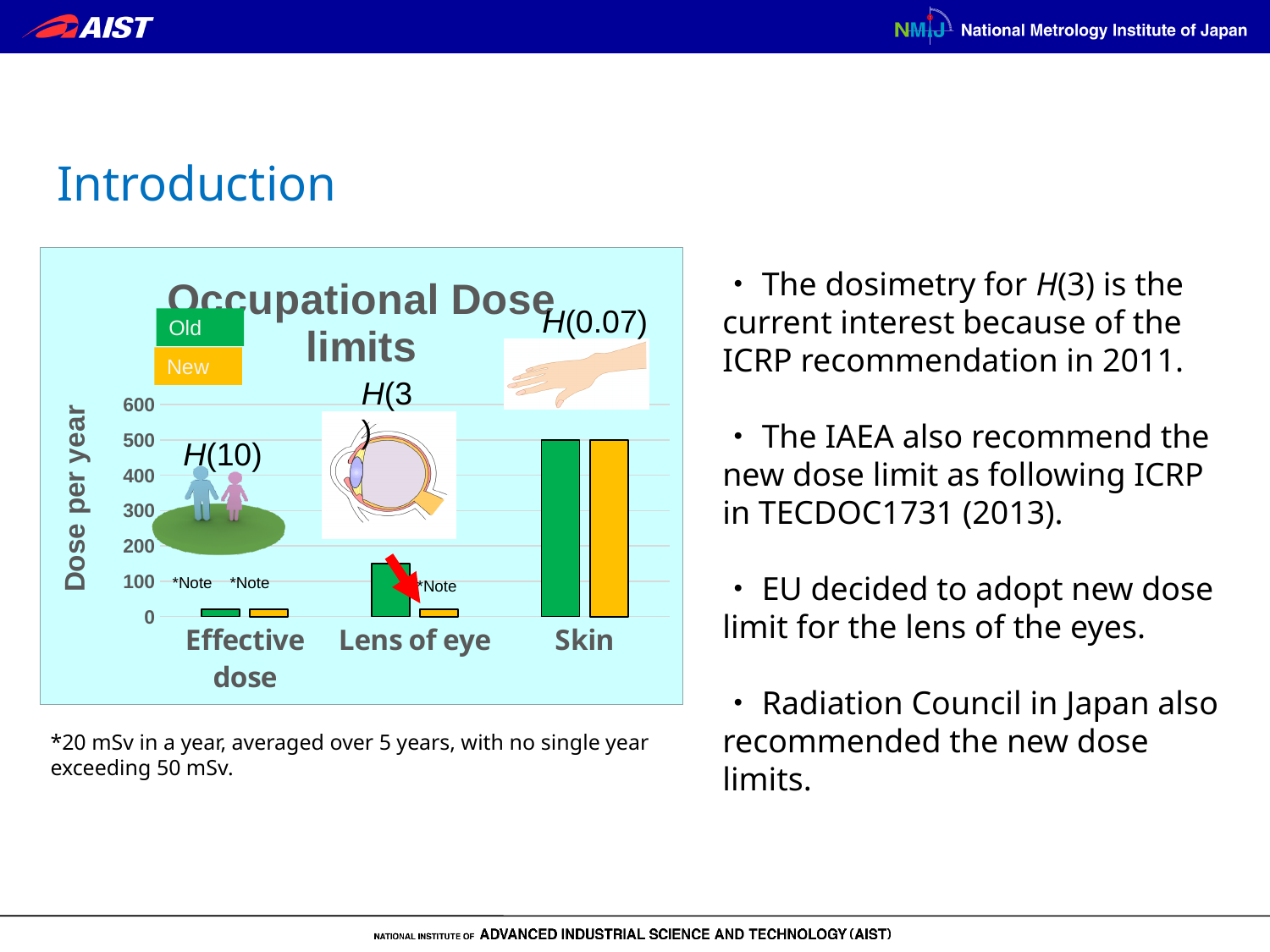
How many series does the legend of the Occupational Dose limits chart list? 2 Which category has the highest Old value in the chart? Skin What kind of chart is shown on the slide? bar chart Is the Old value for Skin greater or less than 400? greater How many categories are shown on the x axis of the Occupational Dose limits chart? 3 Is the Old value for Lens of eye greater or less than 100? greater Is the Old value for Effective dose greater or less than 100? less What are the two legend entries in the Occupational Dose limits chart? Old and New For Lens of eye, which is larger, the Old value or the New value? Old What is the title of the chart? Occupational Dose limits Which category has the lowest Old value in the chart? Effective dose